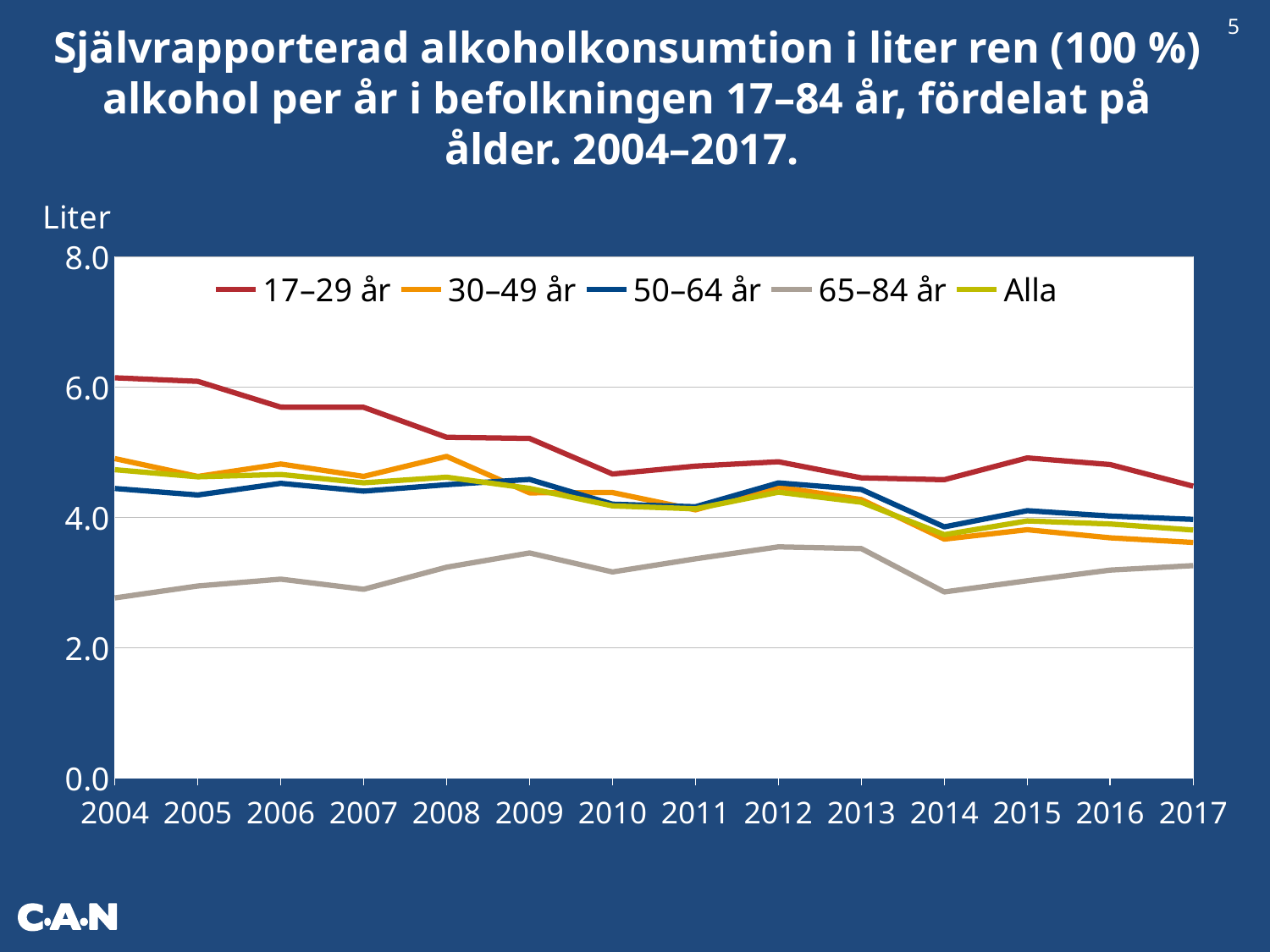
Does the line for 17–29 år generally rise or fall from 2004 to 2017? Fall How many years are shown along the x axis? 14 Is the value for 65–84 år in 2004 greater or less than 3.0? less Is the value for 17–29 år in 2017 greater or less than 4.0? greater Which age group has the highest value in 2004? 17–29 år Which age group has the lowest value in 2017? 65–84 år Which is larger in 2017, the value for 50–64 år or the value for 30–49 år? 50–64 år What unit label is shown above the y axis? Liter What kind of chart is shown on the slide? Line chart How many series does the legend list? 5 Is the value for 65–84 år in 2012 greater or less than 4.0? less Does the line for 65–84 år generally rise or fall from 2004 to 2017? Rise